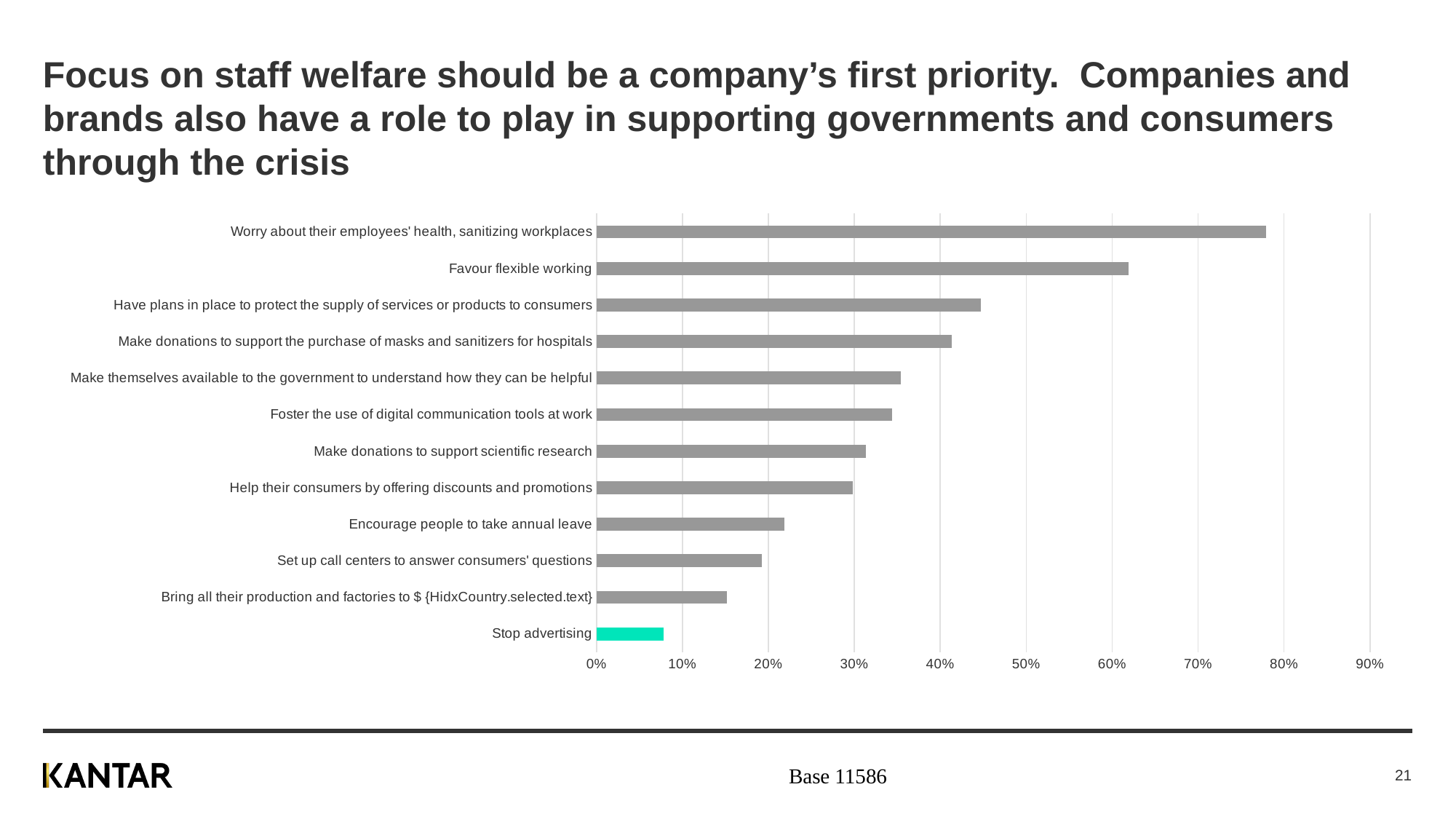
Is the value for "Favour flexible working" greater or less than 50%? greater Which bar is shown in a different colour from the rest? Stop advertising Which is larger: the value for "Favour flexible working" or the value for "Make donations to support scientific research"? Favour flexible working What kind of chart is shown on the slide? bar chart Is the value for "Have plans in place to protect the supply of services or products to consumers" greater or less than 40%? greater Which is larger: the value for "Encourage people to take annual leave" or the value for "Bring all their production and factories to $ {HidxCountry.selected.text}"? Encourage people to take annual leave How many categories are plotted in the chart? 12 Is the value for "Stop advertising" greater or less than 10%? less Which category has the lowest value? Stop advertising Which category has the highest value? Worry about their employees' health, sanitizing workplaces